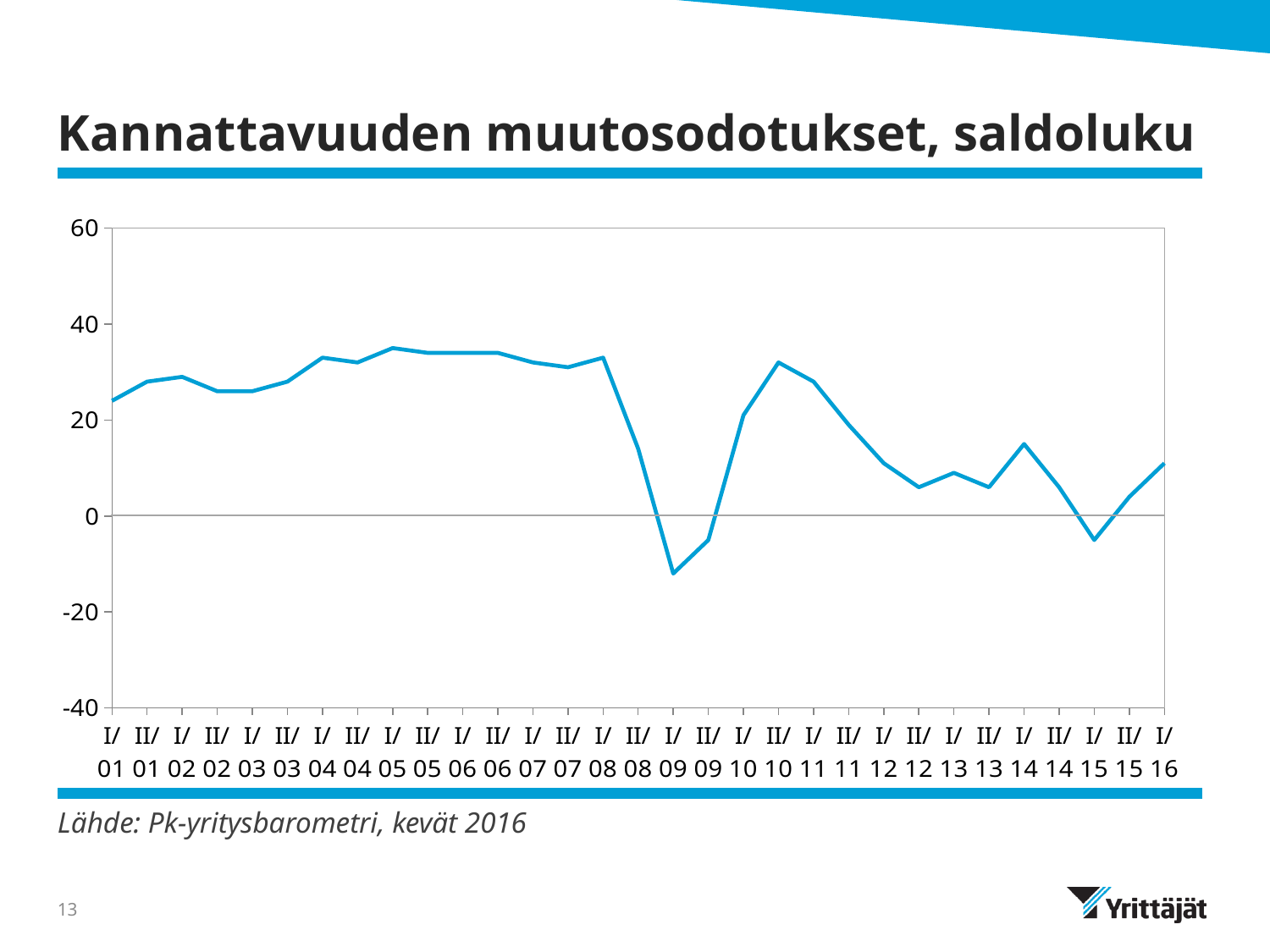
Is the value for I/09 greater or less than 0? less How many data points are plotted on the line chart? 31 Which is larger, the value for II/10 or the value for II/12? II/10 Is the value for I/16 greater or less than 20? less Do the values rise or fall from I/08 to I/09? fall Is the value for II/10 greater or less than 20? greater Which is larger, the value for I/08 or the value for I/09? I/08 What kind of chart is shown on the slide? line chart What is the title of the chart? Kannattavuuden muutosodotukset, saldoluku Which period has the lowest value on the chart? I/09